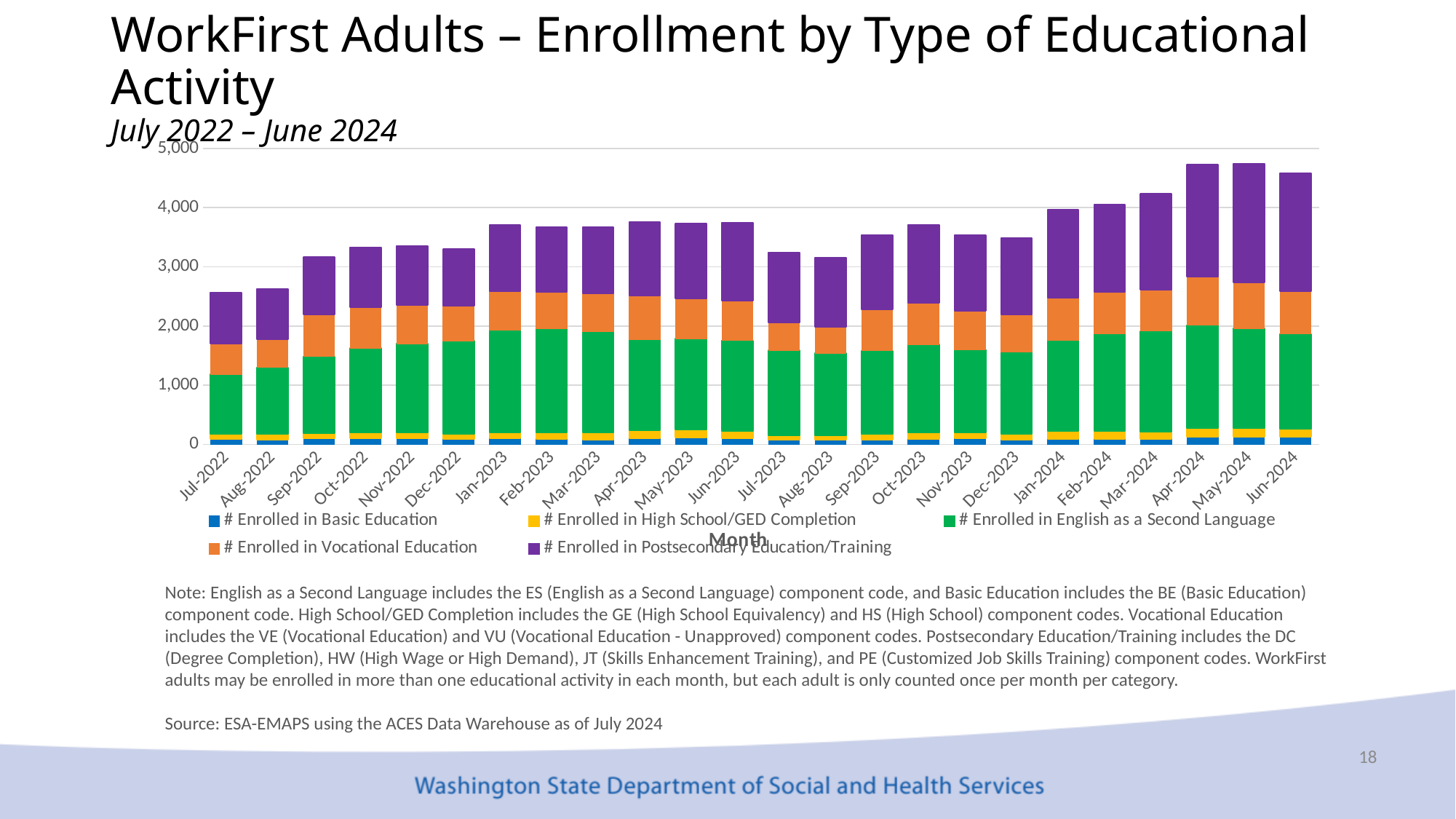
Is the total enrollment bar for Mar-2024 greater or less than 4,000? greater Is the total enrollment bar for Apr-2024 greater or less than 4,000? greater Is the total enrollment bar for Aug-2023 greater or less than 3,000? greater Which has the taller total bar, Jul-2022 or Apr-2024? Apr-2024 Overall, do the total enrollment bars rise or fall from Jul-2022 to Jun-2024? rise How many series does the legend list? 5 How many months are plotted along the x axis? 24 What kind of chart is shown on the slide? Stacked bar chart Which colour represents '# Enrolled in English as a Second Language' in the legend? Green Which has the taller total bar, Jun-2023 or Jul-2023? Jun-2023 What is the x-axis title of the chart? Month